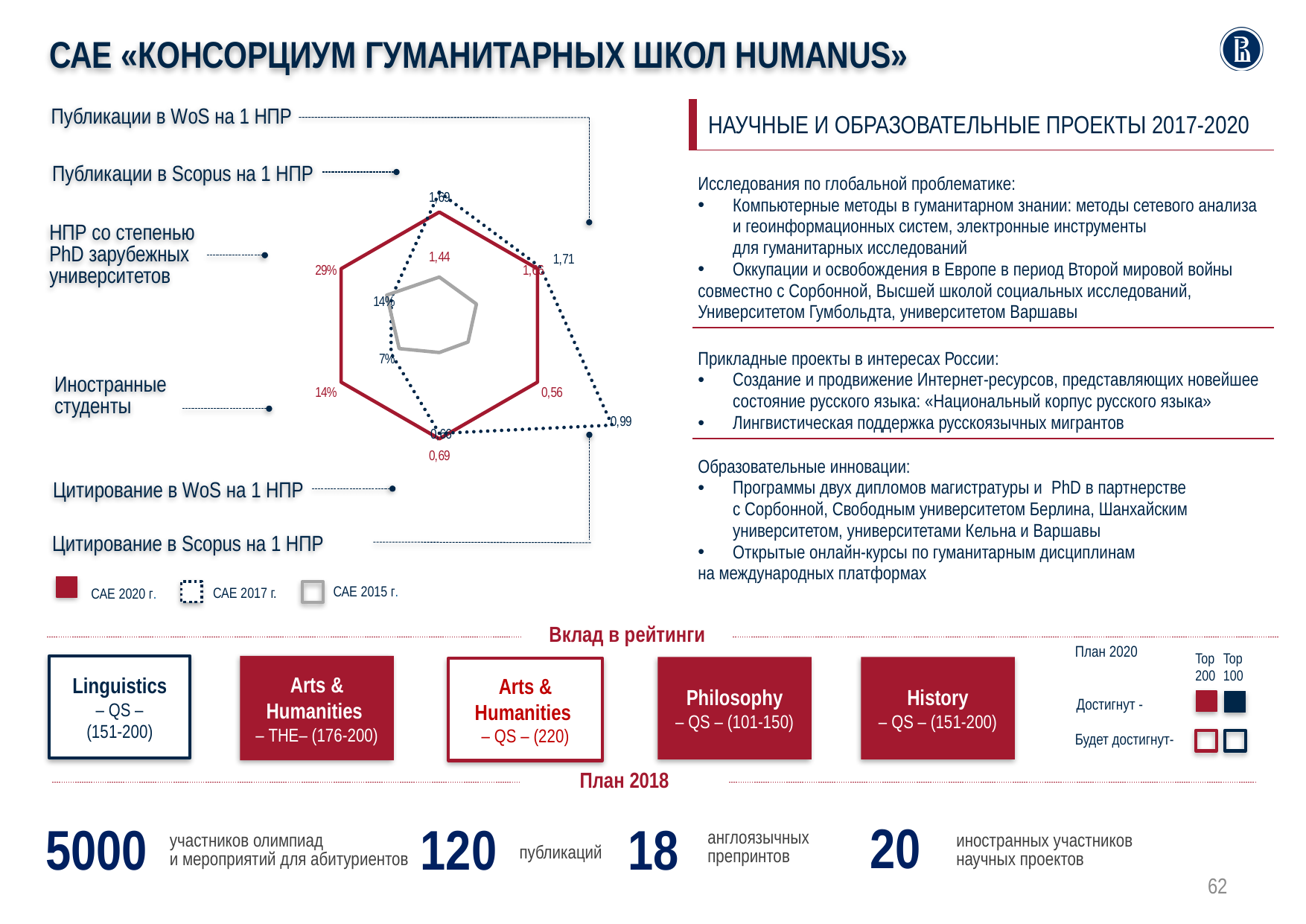
What is the value for Цитирование в Scopus на 1 НПР for САЕ 2020 г.? 0,56 What is the difference between the САЕ 2017 г. and САЕ 2020 г. values for Цитирование в Scopus на 1 НПР? 0,43 What are the three legend entries of the radar chart? САЕ 2020 г., САЕ 2017 г., САЕ 2015 г. What is the value for Публикации в WoS на 1 НПР for САЕ 2020 г.? 1,65 What is the value for Цитирование в Scopus на 1 НПР for САЕ 2017 г.? 0,99 How many indicator axes does the radar chart have? 6 What is the value for НПР со степенью PhD зарубежных университетов for САЕ 2020 г.? 29% What is the value for Иностранные студенты for САЕ 2020 г.? 14% What type of chart is shown on the left of the slide? Radar chart How many series does the legend of the radar chart list? 3 For Цитирование в Scopus на 1 НПР, which series has the larger value: САЕ 2017 г. or САЕ 2020 г.? САЕ 2017 г. What is the value for Публикации в Scopus на 1 НПР for САЕ 2020 г.? 1,44